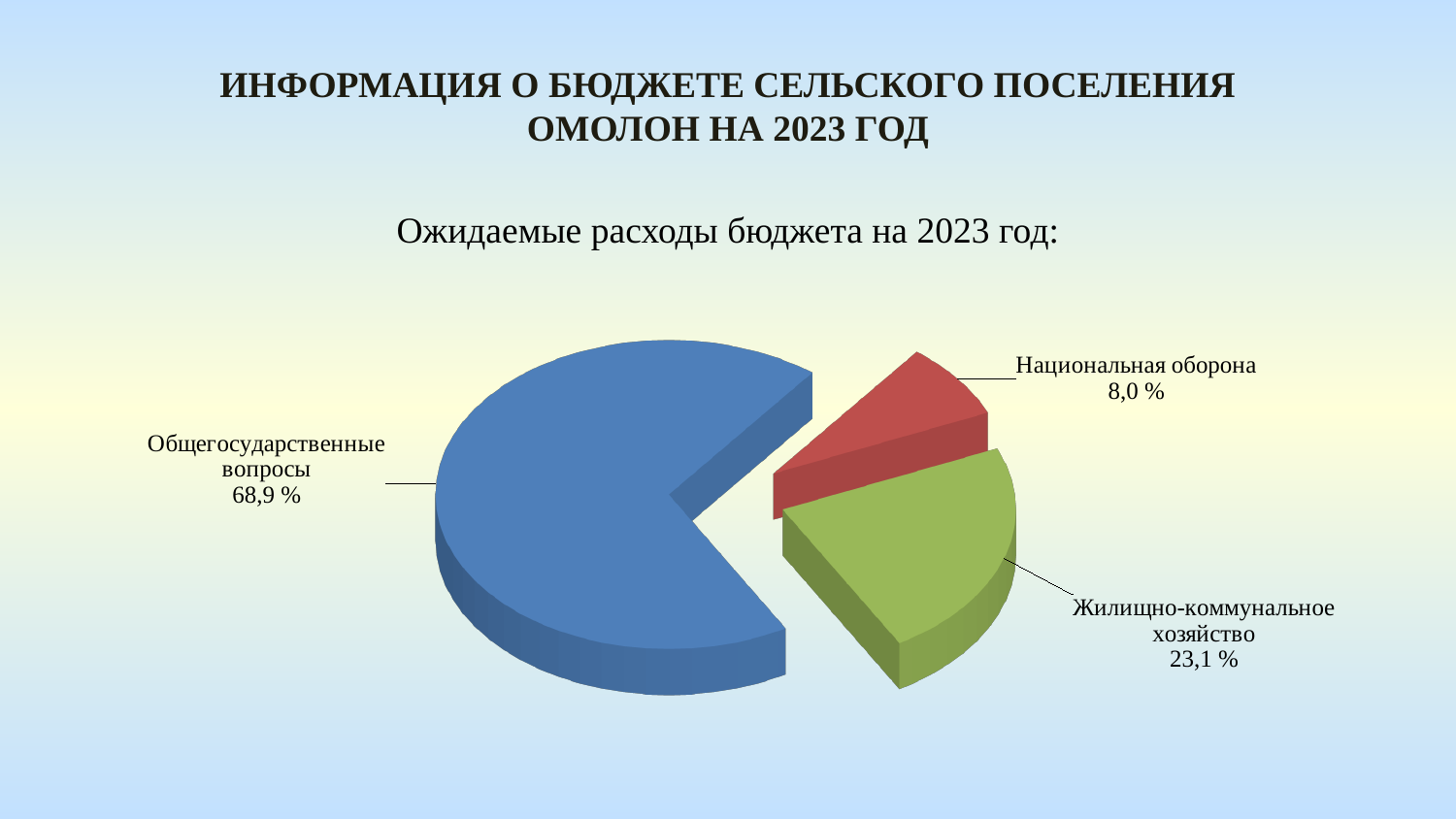
Which expenditure category has the smallest share of the pie? Национальная оборона How many categories are shown in the pie chart? 3 Which expenditure category has the largest share of the pie? Общегосударственные вопросы What colour is the slice for Общегосударственные вопросы? Blue What is the difference in percentage points between the shares of Общегосударственные вопросы and Жилищно-коммунальное хозяйство? 45,8 What share of expected 2023 budget expenditures goes to Национальная оборона? 8,0 % Which has a larger share: Жилищно-коммунальное хозяйство or Национальная оборона? Жилищно-коммунальное хозяйство What is the subtitle above the chart? Ожидаемые расходы бюджета на 2023 год: What share of expected 2023 budget expenditures goes to Жилищно-коммунальное хозяйство? 23,1 % What is the difference in percentage points between the shares of Жилищно-коммунальное хозяйство and Национальная оборона? 15,1 What share of expected 2023 budget expenditures goes to Общегосударственные вопросы? 68,9 % What kind of chart is shown on the slide? Pie chart